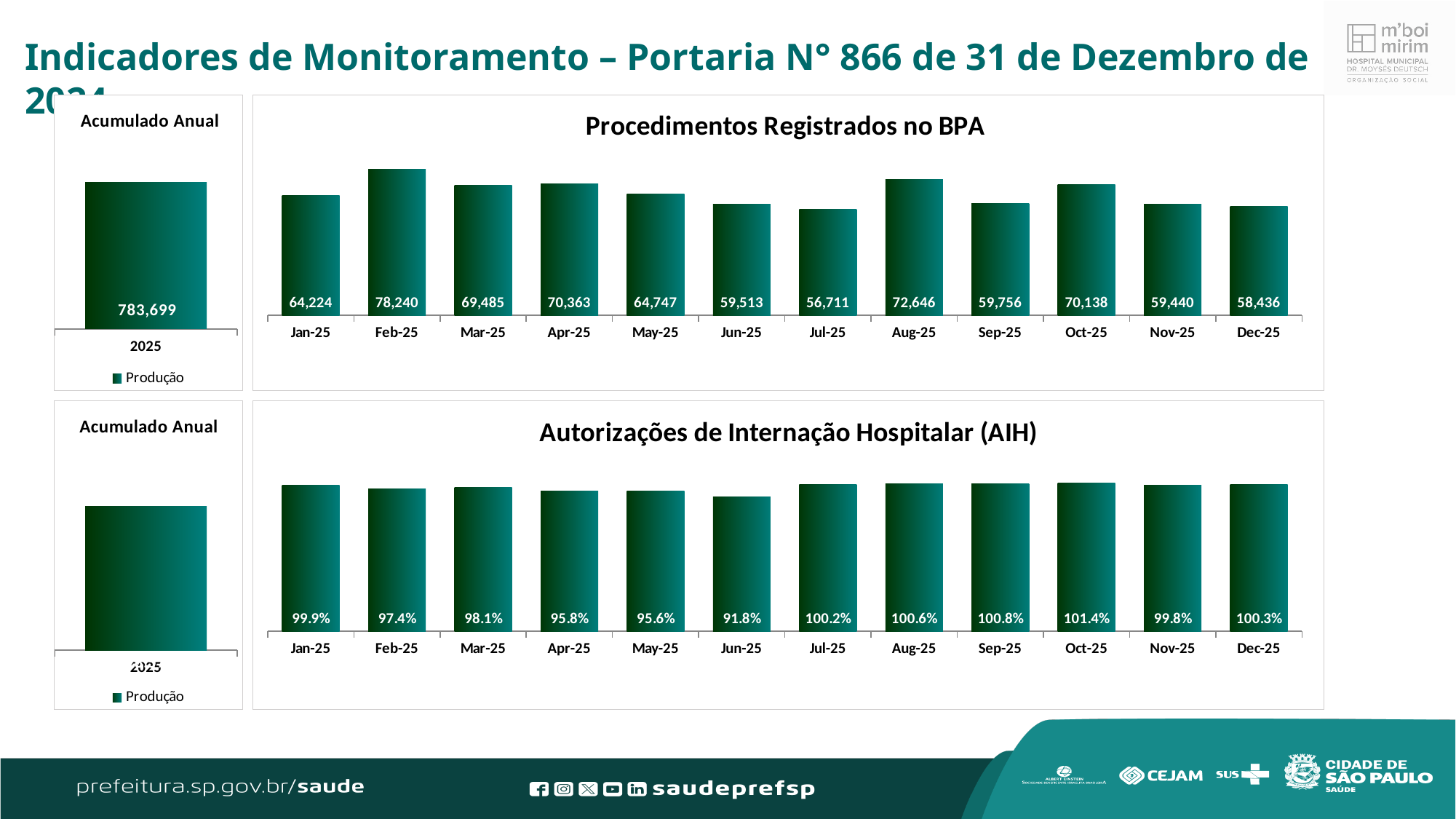
In the 'Procedimentos Registrados no BPA' chart, which month has the lowest value? Jul-25 In the 'Autorizações de Internação Hospitalar (AIH)' chart, what is the value for Dec-25? 100.3% In the 'Autorizações de Internação Hospitalar (AIH)' chart, what is the value for Jun-25? 91.8% How many months are plotted in the 'Procedimentos Registrados no BPA' chart? 12 In the 'Procedimentos Registrados no BPA' chart, what is the value for Feb-25? 78,240 What type of chart is 'Procedimentos Registrados no BPA'? Bar chart In the 'Procedimentos Registrados no BPA' chart, which is larger: Apr-25 or Oct-25? Apr-25 In the 'Procedimentos Registrados no BPA' chart, what is the difference between the Feb-25 and Jul-25 values? 21,529 In the 'Procedimentos Registrados no BPA' chart, which month has the highest value? Feb-25 In the top-left 'Acumulado Anual' chart, what is the value shown for 2025? 783,699 In the 'Autorizações de Internação Hospitalar (AIH)' chart, which is larger: Feb-25 or Mar-25? Mar-25 In the 'Autorizações de Internação Hospitalar (AIH)' chart, which month has the highest value? Oct-25